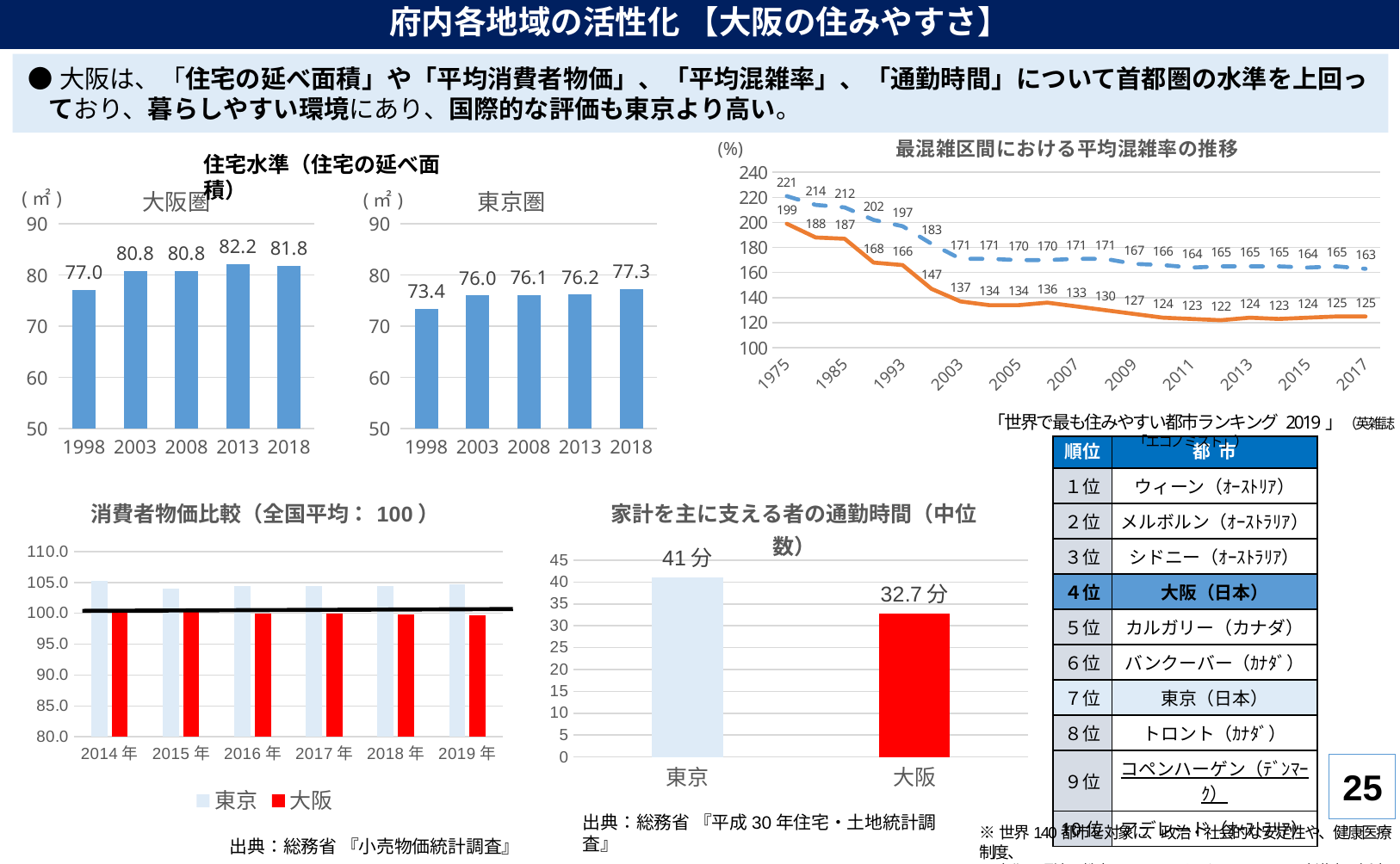
In the 大阪圏 housing floor area chart, what is the value for 2013? 82.2 How many bars are in the 東京圏 housing floor area chart? 5 How many series does the legend of the 消費者物価比較 chart list? 2 In the 最混雑区間における平均混雑率の推移 chart, what is the value of the orange line at 2017? 125 In the 最混雑区間における平均混雑率の推移 chart, do the values of the orange line generally rise or fall from 1975 to 2017? fall In the 最混雑区間における平均混雑率の推移 chart, what is the first value of the dashed line at 1975? 221 In the 家計を主に支える者の通勤時間 chart, what is the difference between the 東京 and 大阪 values? 8.3分 In the 消費者物価比較 chart, is the value for 東京 in 2014年 greater or less than 100.0? greater What kind of chart is 最混雑区間における平均混雑率の推移? line chart In the 東京圏 housing floor area chart, what is the difference between the 2018 and 1998 values? 3.9 In the 東京圏 housing floor area chart, what is the value for 2018? 77.3 In the 大阪圏 housing floor area chart, which year has the lowest value? 1998